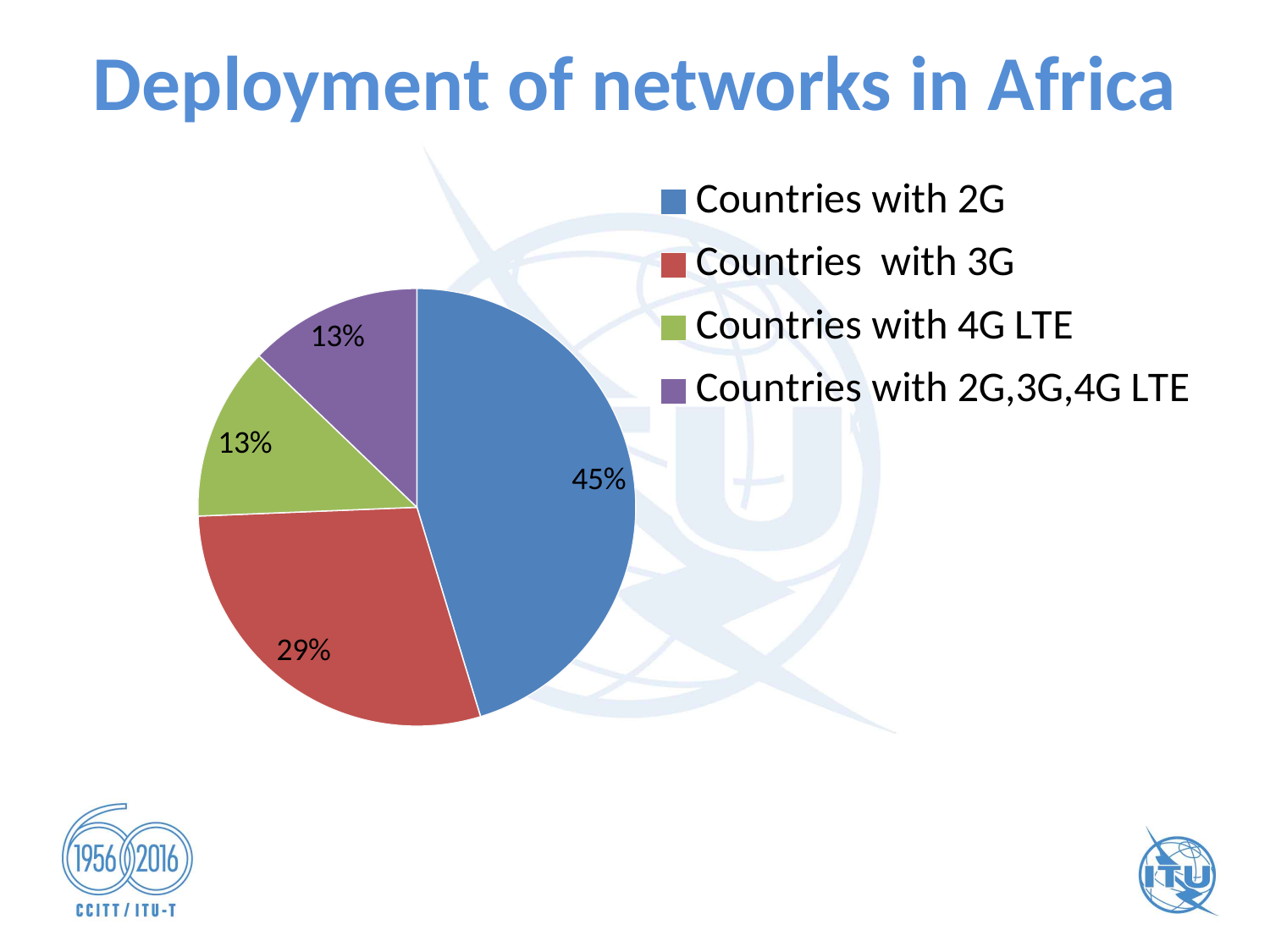
What share of the pie is labelled for Countries with 2G? 45% How many entries does the legend list? 4 What colour is the slice for Countries with 4G LTE? green How many slices does the pie chart have? 4 What is the title of the slide containing the chart? Deployment of networks in Africa Which is larger, the slice for Countries with 3G or the slice for Countries with 4G LTE? Countries with 3G What kind of chart is shown on the slide? pie chart What share of the pie is labelled for Countries with 3G? 29% What share of the pie is labelled for Countries with 4G LTE? 13% What is the difference in percentage points between the Countries with 2G slice and the Countries with 3G slice? 16 Which category has the largest slice of the pie? Countries with 2G